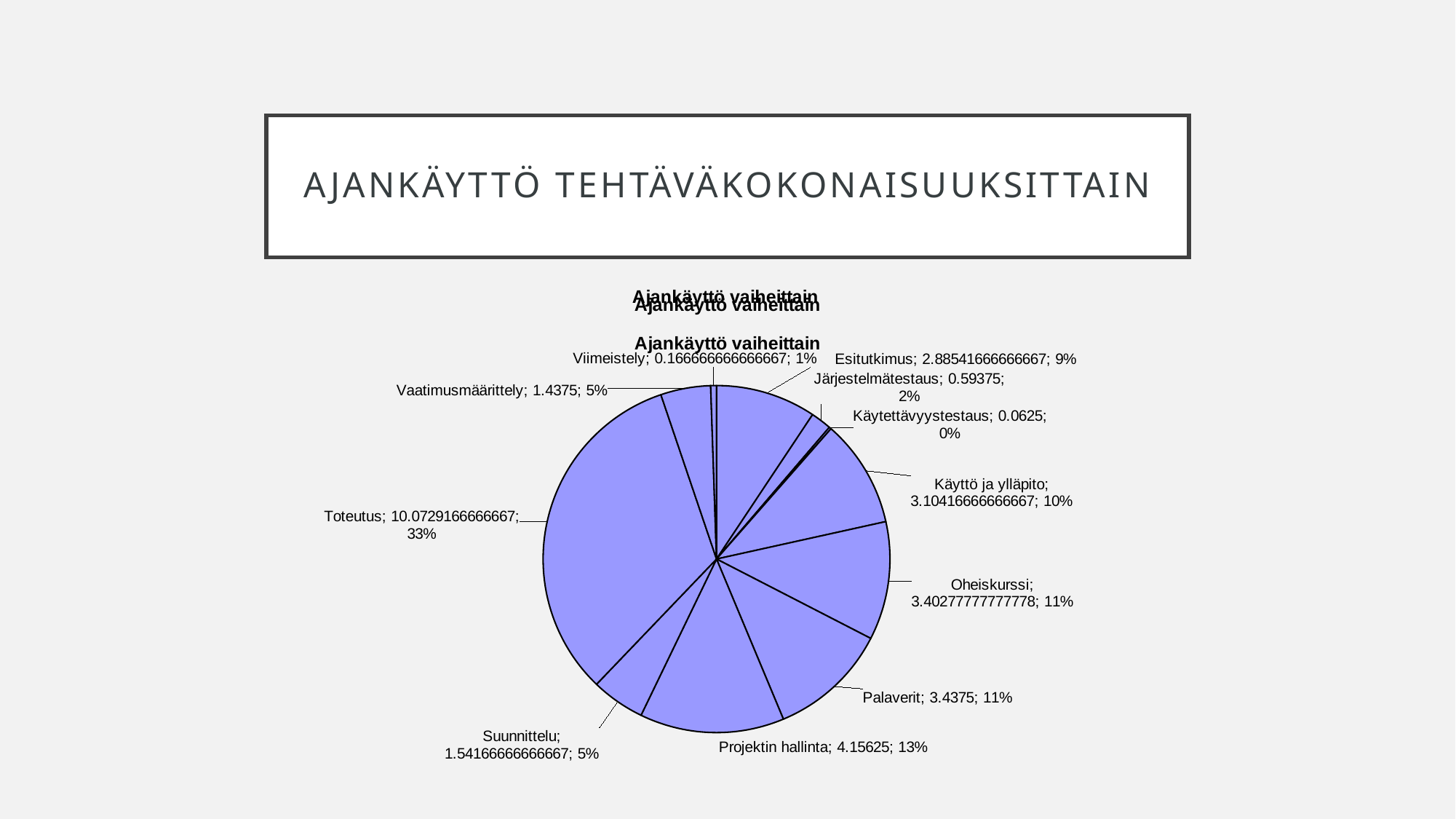
Which is larger, the value for Toteutus or the value for Esitutkimus? Toteutus Which category has the largest slice of the pie? Toteutus What is the title of the chart? Ajankäyttö vaiheittain What is the value for Palaverit? 3.4375 What is the value for Projektin hallinta? 4.15625 Which category has the smallest slice of the pie? Käytettävyystestaus What kind of chart is shown on the slide? pie chart What share of the pie does Toteutus represent? 33% What is the value for Järjestelmätestaus? 0.59375 What share of the pie does Projektin hallinta represent? 13% How many slices does the pie chart have? 11 What is the value for Vaatimusmäärittely? 1.4375